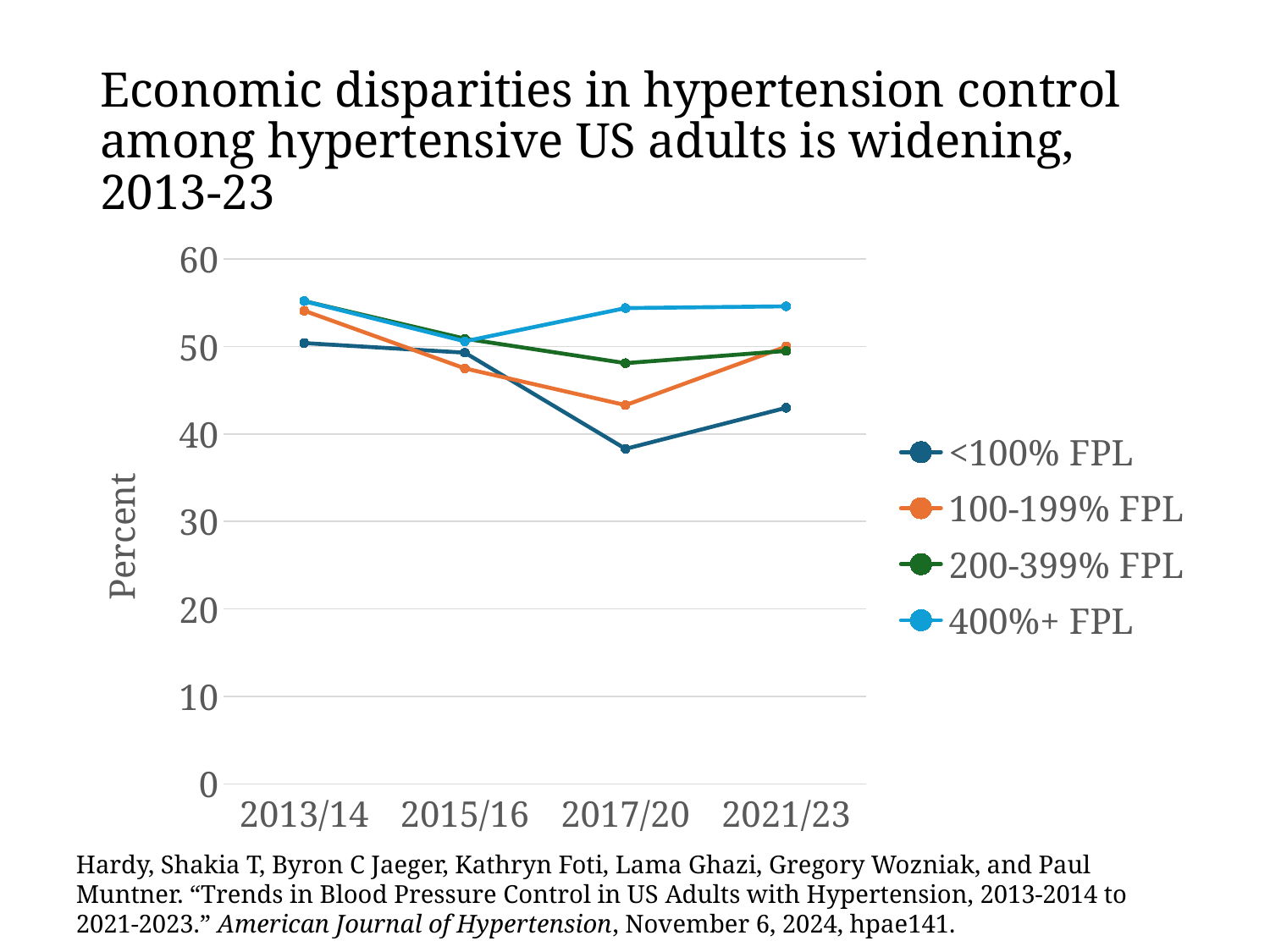
What kind of chart is shown on the slide? Line chart Which series has the highest value in 2021/23? 400%+ FPL How many series does the legend list? 4 Is the value for <100% FPL in 2017/20 greater or less than 40? less Is the value for 400%+ FPL in 2021/23 greater or less than 50? greater How many time periods are shown on the x axis? 4 Which series has the lowest value in 2021/23? <100% FPL Which series has the lowest value in 2013/14? <100% FPL Does the <100% FPL line rise or fall overall from 2013/14 to 2021/23? Fall What is the label on the y axis? Percent Which series has the lowest value in 2017/20? <100% FPL In 2017/20, which is larger: the value for <100% FPL or the value for 100-199% FPL? 100-199% FPL